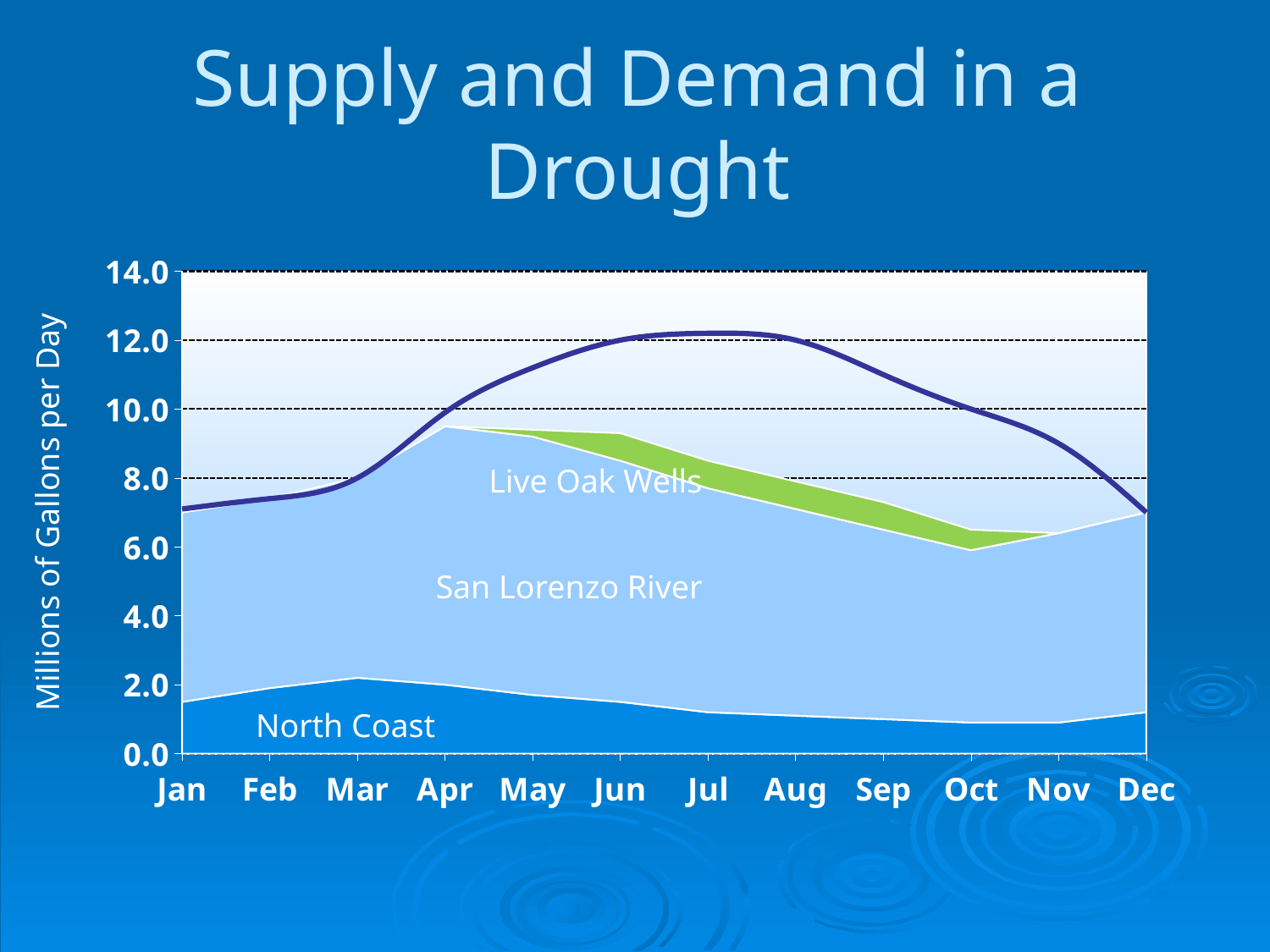
Is the total stacked supply in Apr greater or less than 10.0? less In which month is the North Coast area at its highest? Mar What is the label on the y axis? Millions of Gallons per Day Is the demand line in Jan greater or less than 8.0? less Does the demand line rise or fall from Jul to Dec? fall Which supply source is the bottom area of the stack? North Coast What kind of chart is shown on the slide? Stacked area chart with a line Is the demand line in Sep greater or less than 10.0? greater How many supply sources are labelled as areas in the chart? 3 In which month does the demand line reach its highest point? Jul How many months are shown along the x axis? 12 Is the demand line higher in Jul or in Jan? Jul